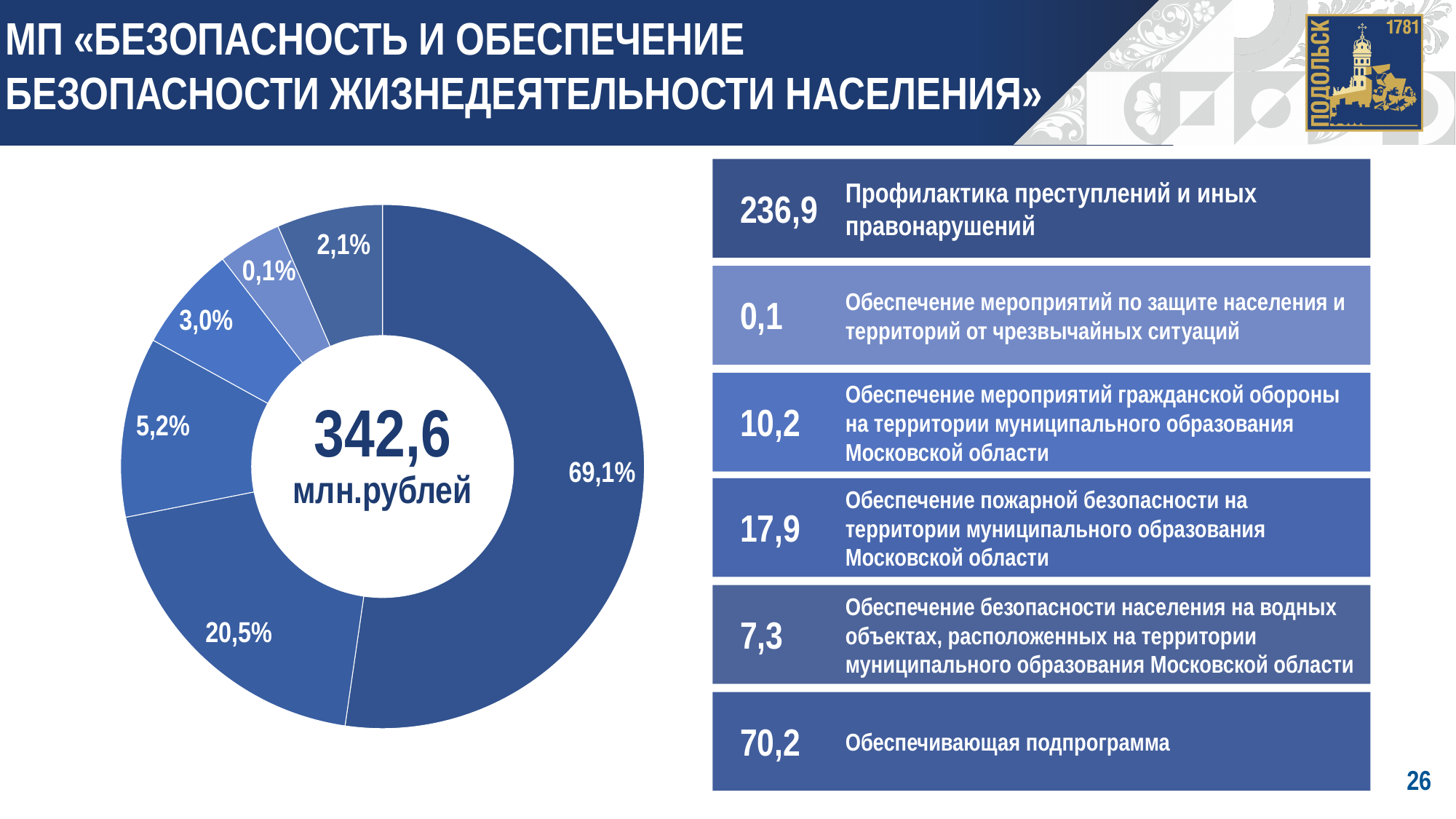
What amount is listed for «Обеспечивающая подпрограмма»? 70,2 What is the difference in percentage points between the 69,1% slice and the 20,5% slice? 48,6 What amount is listed for «Обеспечение пожарной безопасности на территории муниципального образования Московской области»? 17,9 What total value is shown in the centre of the donut chart? 342,6 млн.рублей What is the second-largest share shown on the donut chart? 20,5% What amount is listed for «Профилактика преступлений и иных правонарушений»? 236,9 What is the smallest share shown on the donut chart? 0,1% Which is larger on the donut chart: the 5,2% slice or the 3,0% slice? 5,2% What type of chart is shown on the slide? pie chart (donut) What is the largest share shown on the donut chart? 69,1% How many slices does the donut chart have? 6 Which listed subprogram has the smallest amount? Обеспечение мероприятий по защите населения и территорий от чрезвычайных ситуаций